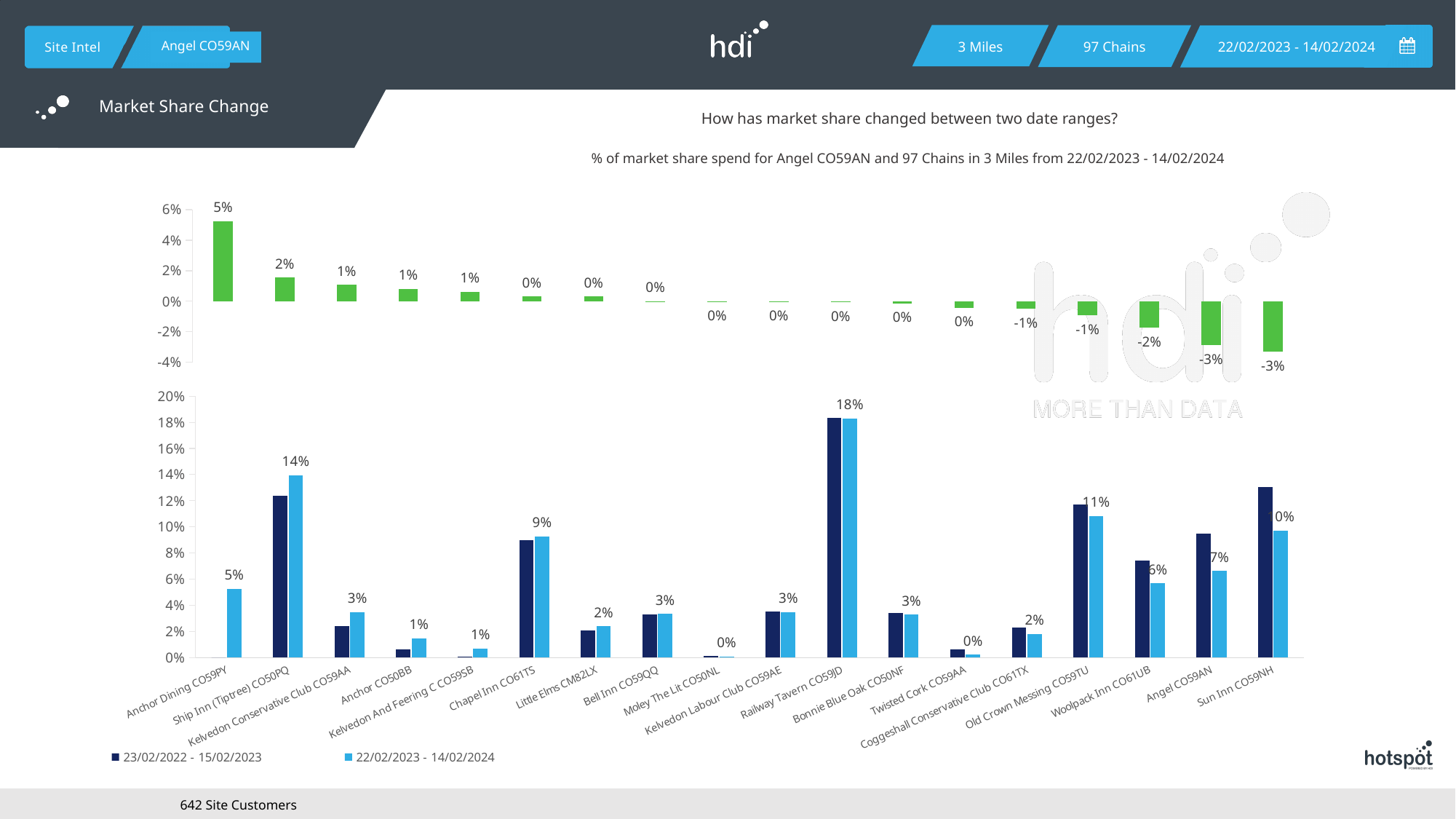
In the bottom chart, which category has the highest value in the 22/02/2023 - 14/02/2024 series? Railway Tavern CO59JD In the bottom chart, what is the value for Railway Tavern CO59JD in the 22/02/2023 - 14/02/2024 series? 18% How many series does the legend of the bottom chart list? 2 In the bottom chart, which is larger in the 22/02/2023 - 14/02/2024 series: Ship Inn (Tiptree) CO50PQ or Chapel Inn CO61TS? Ship Inn (Tiptree) CO50PQ In the bottom chart, is the value for Ship Inn (Tiptree) CO50PQ in the 23/02/2022 - 15/02/2023 series greater or less than 10%? greater In the bottom chart, what is the difference between Railway Tavern CO59JD and Old Crown Messing CO59TU in the 22/02/2023 - 14/02/2024 series? 7% How many categories are shown on the x axis of the bottom chart? 18 In the top chart (market share change), what is the value for Anchor Dining CO59PY? 5% In the top chart (market share change), which category has the highest value? Anchor Dining CO59PY What is the subtitle printed above the charts describing the data? % of market share spend for Angel CO59AN and 97 Chains in 3 Miles from 22/02/2023 - 14/02/2024 In the top chart (market share change), what is the value for Woolpack Inn CO61UB? -2% What kind of chart is the bottom chart on the slide? Bar chart